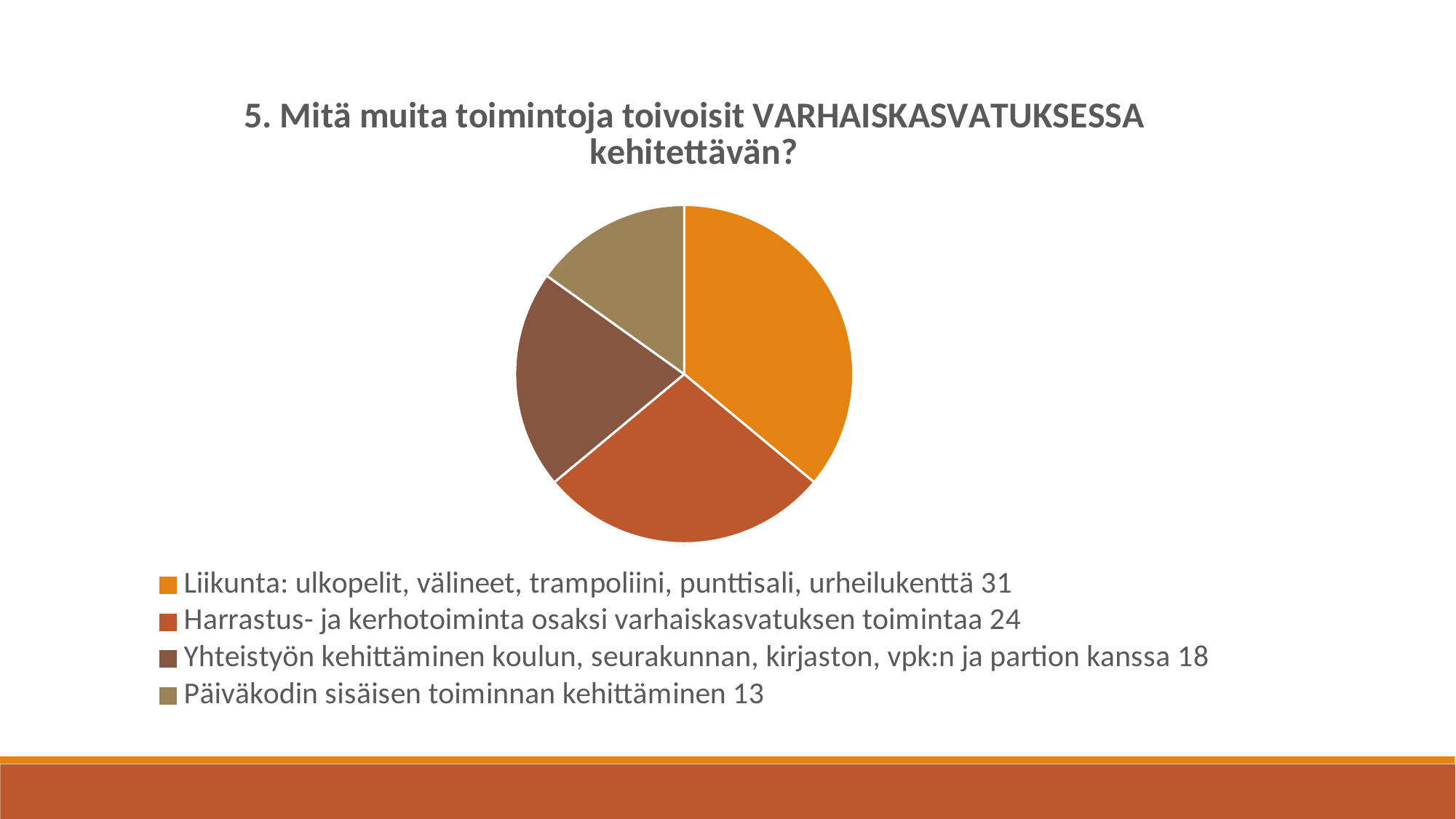
Which category has the smallest slice of the pie? Päiväkodin sisäisen toiminnan kehittäminen What colour is the slice for "Liikunta: ulkopelit, välineet, trampoliini, punttisali, urheilukenttä"? orange What is the value for "Liikunta: ulkopelit, välineet, trampoliini, punttisali, urheilukenttä"? 31 What is the total of all four values shown in the legend? 86 What is the value for "Harrastus- ja kerhotoiminta osaksi varhaiskasvatuksen toimintaa"? 24 Which category has the largest slice of the pie? Liikunta: ulkopelit, välineet, trampoliini, punttisali, urheilukenttä What is the value for "Päiväkodin sisäisen toiminnan kehittäminen"? 13 What is the value for "Yhteistyön kehittäminen koulun, seurakunnan, kirjaston, vpk:n ja partion kanssa"? 18 How many slices does the pie chart have? 4 What type of chart is shown on the slide? pie chart What is the difference between the value for "Liikunta" and the value for "Harrastus- ja kerhotoiminta"? 7 Which is larger: the value for "Yhteistyön kehittäminen" or the value for "Päiväkodin sisäisen toiminnan kehittäminen"? Yhteistyön kehittäminen